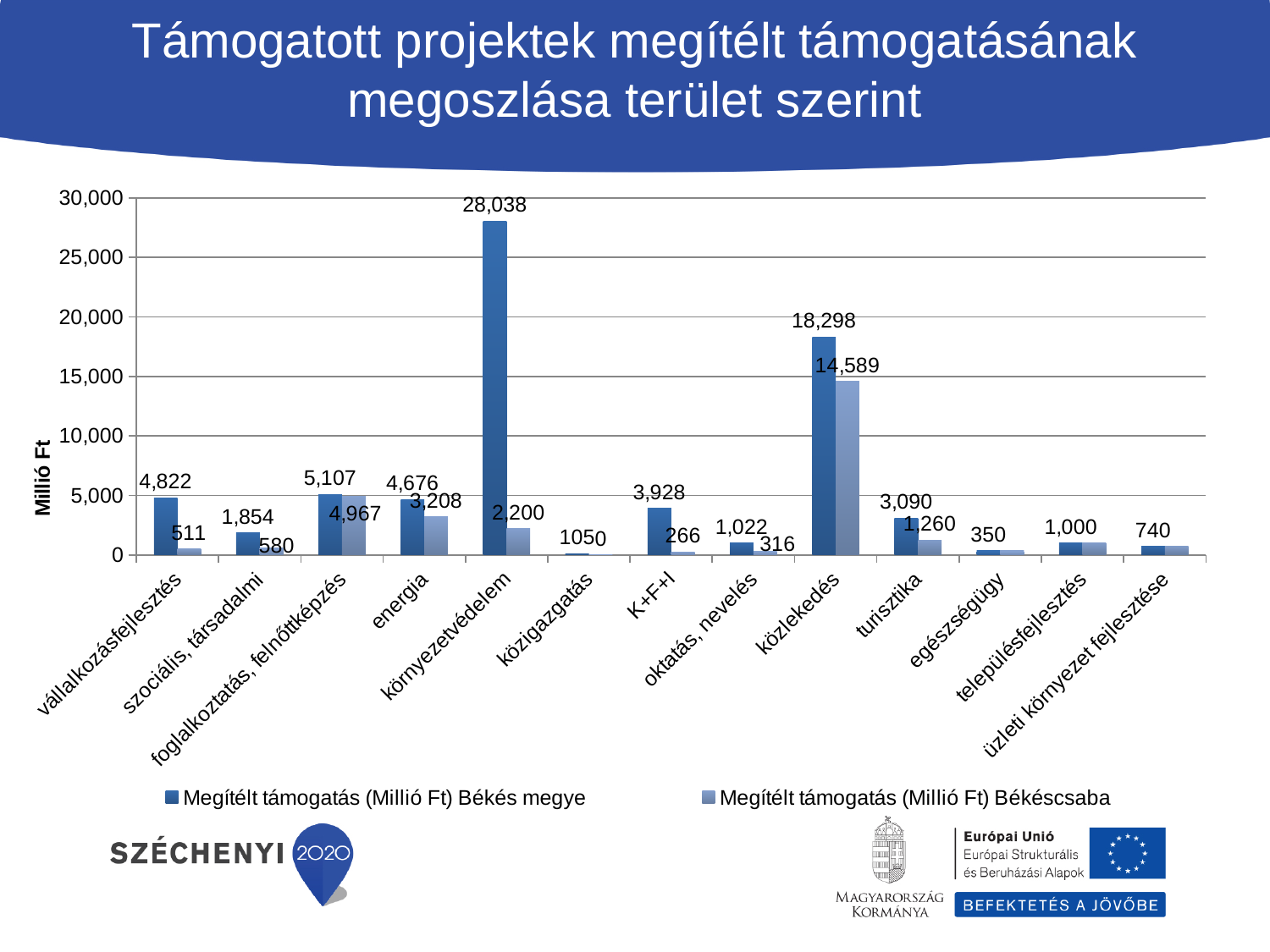
What is the Békéscsaba value for energia? 3,208 What is the difference between the Békés megye and Békéscsaba values for környezetvédelem? 25,838 What kind of chart is shown on the slide? bar chart What is the Megítélt támogatás (Millió Ft) Békéscsaba value for közlekedés? 14,589 Which category has the highest Békés megye value? környezetvédelem Which is larger for K+F+I: the Békés megye value or the Békéscsaba value? Békés megye Which category has the highest Békéscsaba value? közlekedés How many series does the legend list? 2 What is the difference between the Békés megye and Békéscsaba values for közlekedés? 3,709 What is the Békés megye value for foglalkoztatás, felnőttképzés? 5,107 How many categories are shown on the x axis? 13 What is the Megítélt támogatás (Millió Ft) Békés megye value for környezetvédelem? 28,038